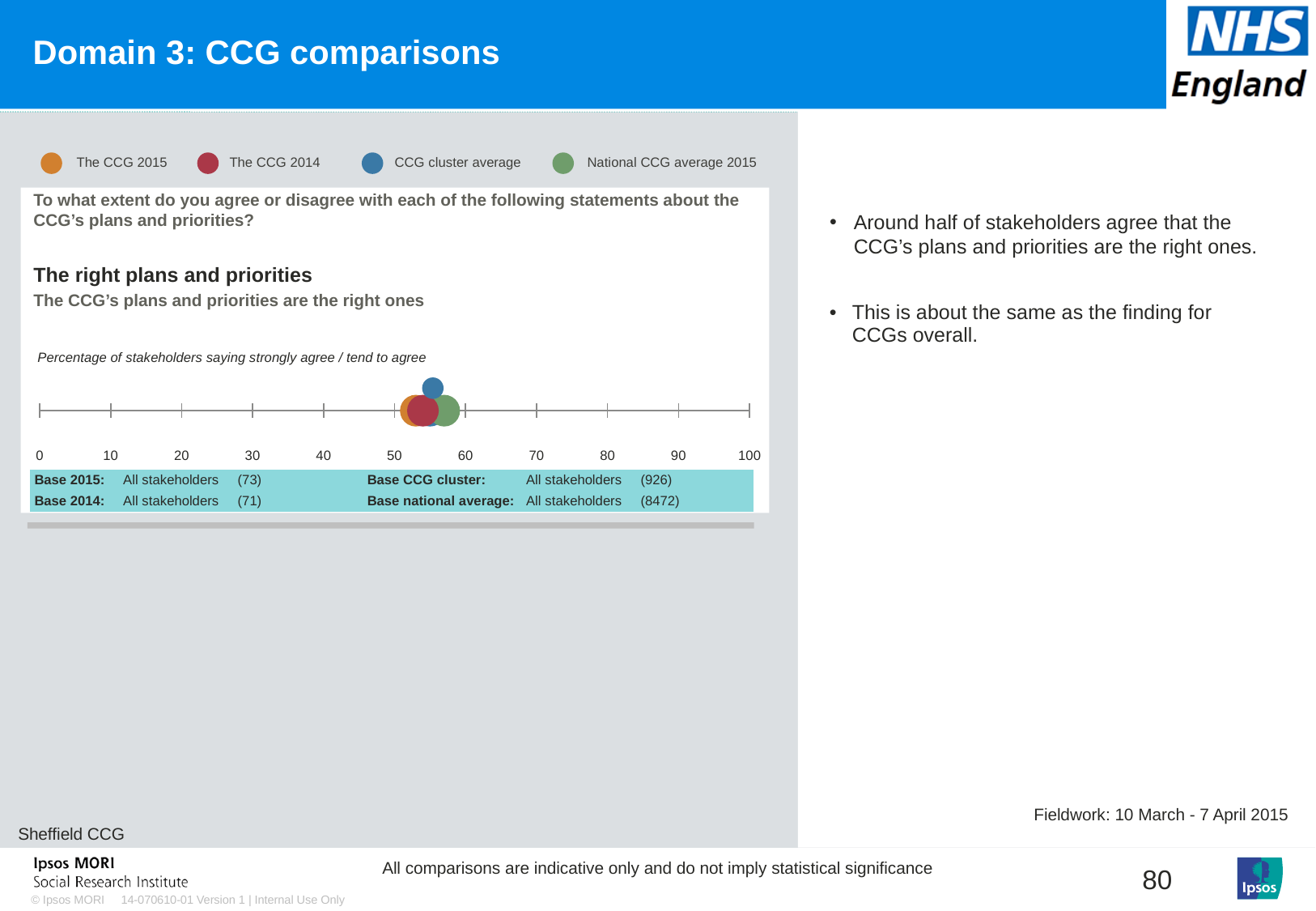
Is the value for National CCG average 2015 greater or less than 50? greater What is the maximum value shown on the chart's axis? 100 Is the value for CCG cluster average greater or less than 50? greater What kind of chart is used to show the percentage of stakeholders agreeing? Dot plot What statement does the chart measure agreement with? The CCG's plans and priorities are the right ones Which colour represents The CCG 2015 in the legend? Orange Is the value for CCG cluster average greater or less than 60? less How many series does the legend list for the chart? 4